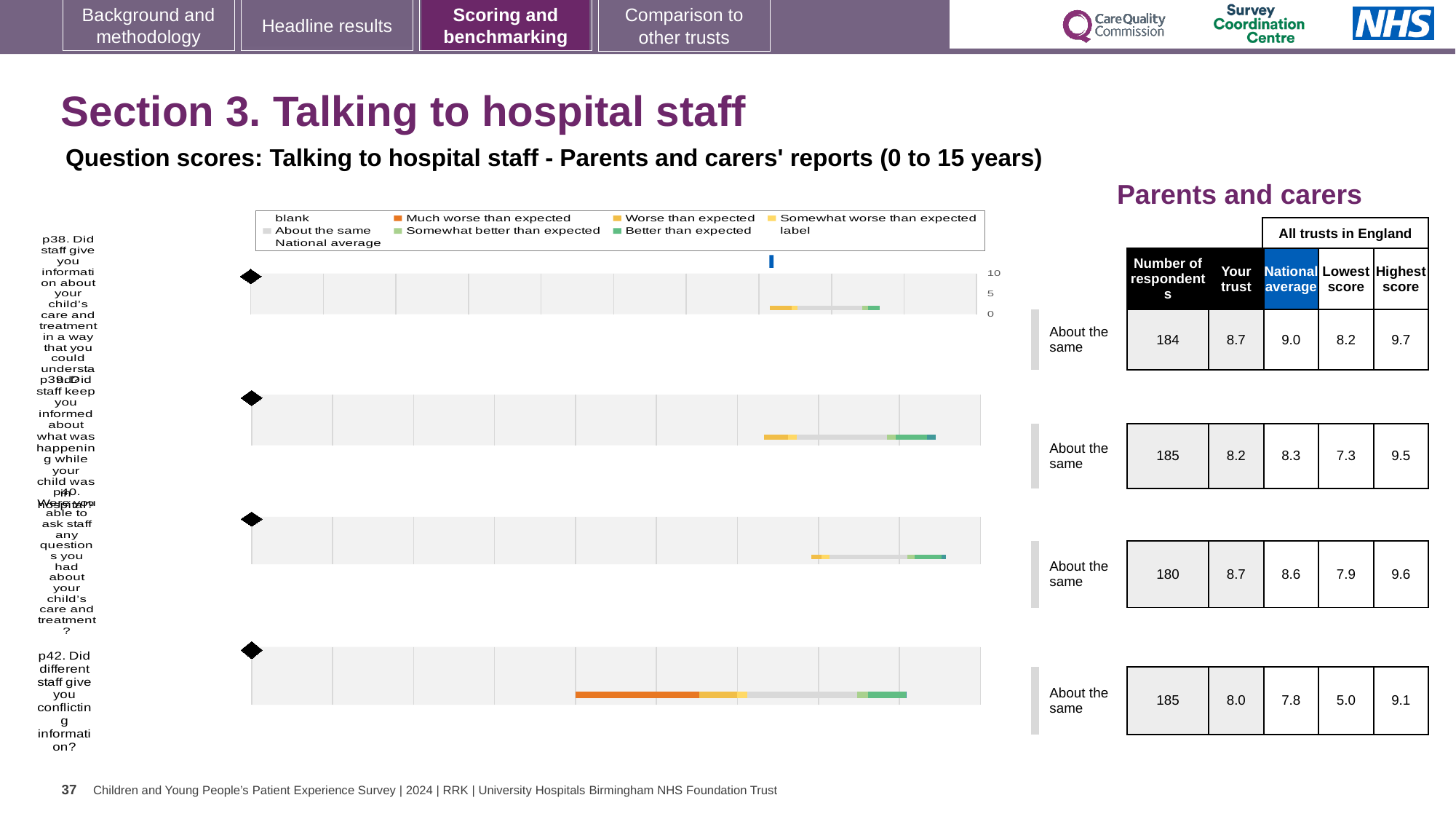
In the table on the right, which question has the lowest 'Your trust' score? p42. Did different staff give you conflicting information? In the table on the right, how many respondents answered p40 (able to ask staff questions)? 180 How many entries does the legend above the bar charts list? 9 How many question-score bar charts are shown on the slide? 4 Which legend entry is shown in orange? Much worse than expected In the table on the right, what is the difference between the Highest score and Lowest score for p38? 1.5 In the table on the right, what is the National average for p39 (staff keeping you informed)? 8.3 What is the highest tick value shown on the axis of the first bar chart? 10 What kind of chart is used for the question scores on this slide? bar chart In the table on the right, what is the 'Your trust' score for p38 (information about your child's care and treatment)? 8.7 In the table on the right, is the 'Your trust' score for p40 larger or smaller than its National average? larger In the table on the right, what is the Lowest score for p42 (conflicting information)? 5.0